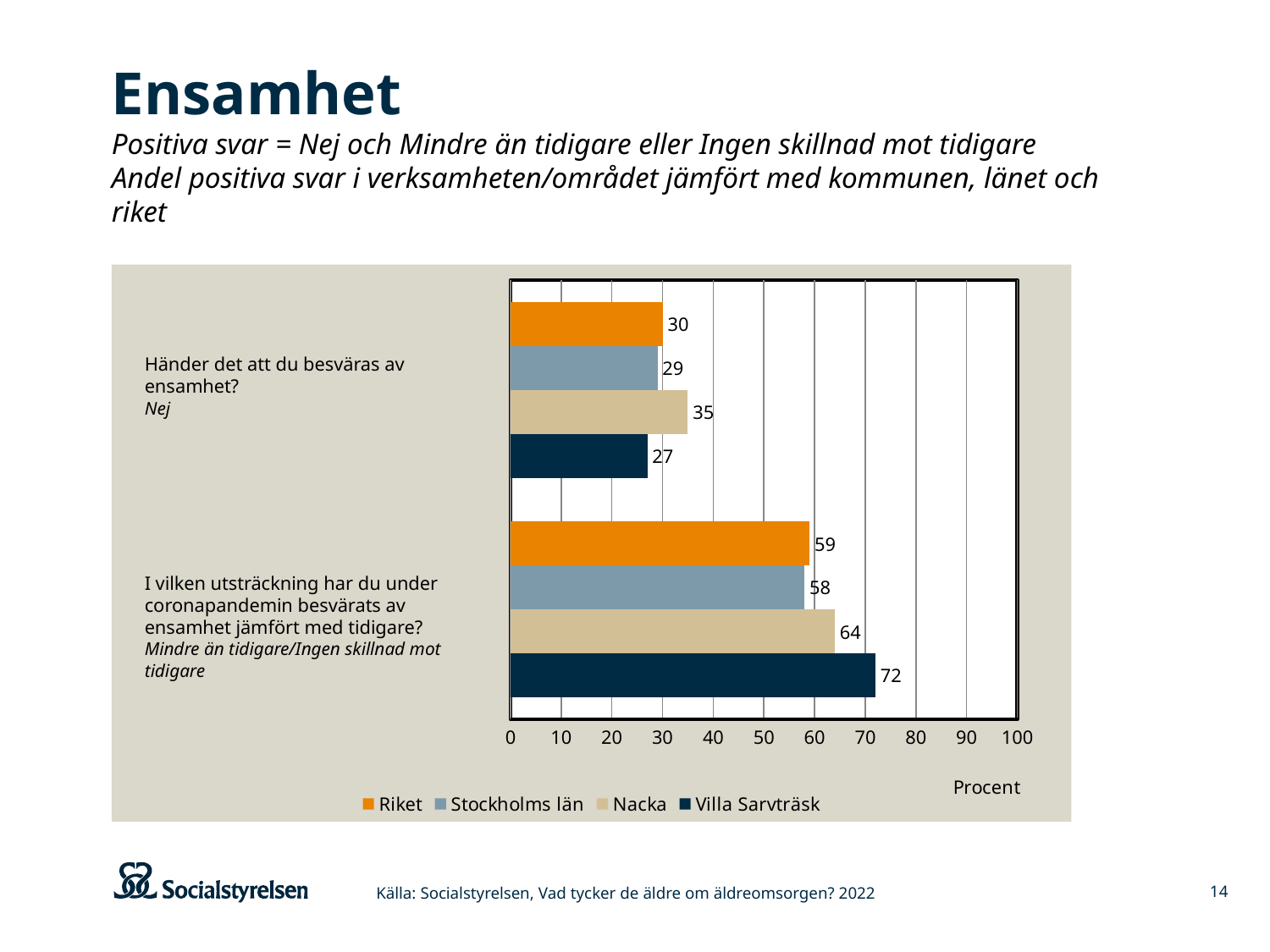
What is the value for Riket on the question 'Händer det att du besväras av ensamhet?' 30 What is the value for Villa Sarvträsk on the question 'I vilken utsträckning har du under coronapandemin besvärats av ensamhet jämfört med tidigare?' 72 Which is larger on the question 'Händer det att du besväras av ensamhet?': Nacka or Stockholms län? Nacka What is the difference between Villa Sarvträsk and Riket on the question 'I vilken utsträckning har du under coronapandemin besvärats av ensamhet jämfört med tidigare?' 13 Which series has the highest value on the question 'I vilken utsträckning har du under coronapandemin besvärats av ensamhet jämfört med tidigare?' Villa Sarvträsk What is the value for Stockholms län on the question 'I vilken utsträckning har du under coronapandemin besvärats av ensamhet jämfört med tidigare?' 58 What is the difference between Nacka and Villa Sarvträsk on the question 'Händer det att du besväras av ensamhet?' 8 What unit is shown on the x axis of the chart? Procent What kind of chart is shown on the slide? Bar chart How many series does the legend list? 4 What is the value for Nacka on the question 'Händer det att du besväras av ensamhet?' 35 Which series has the lowest value on the question 'Händer det att du besväras av ensamhet?' Villa Sarvträsk